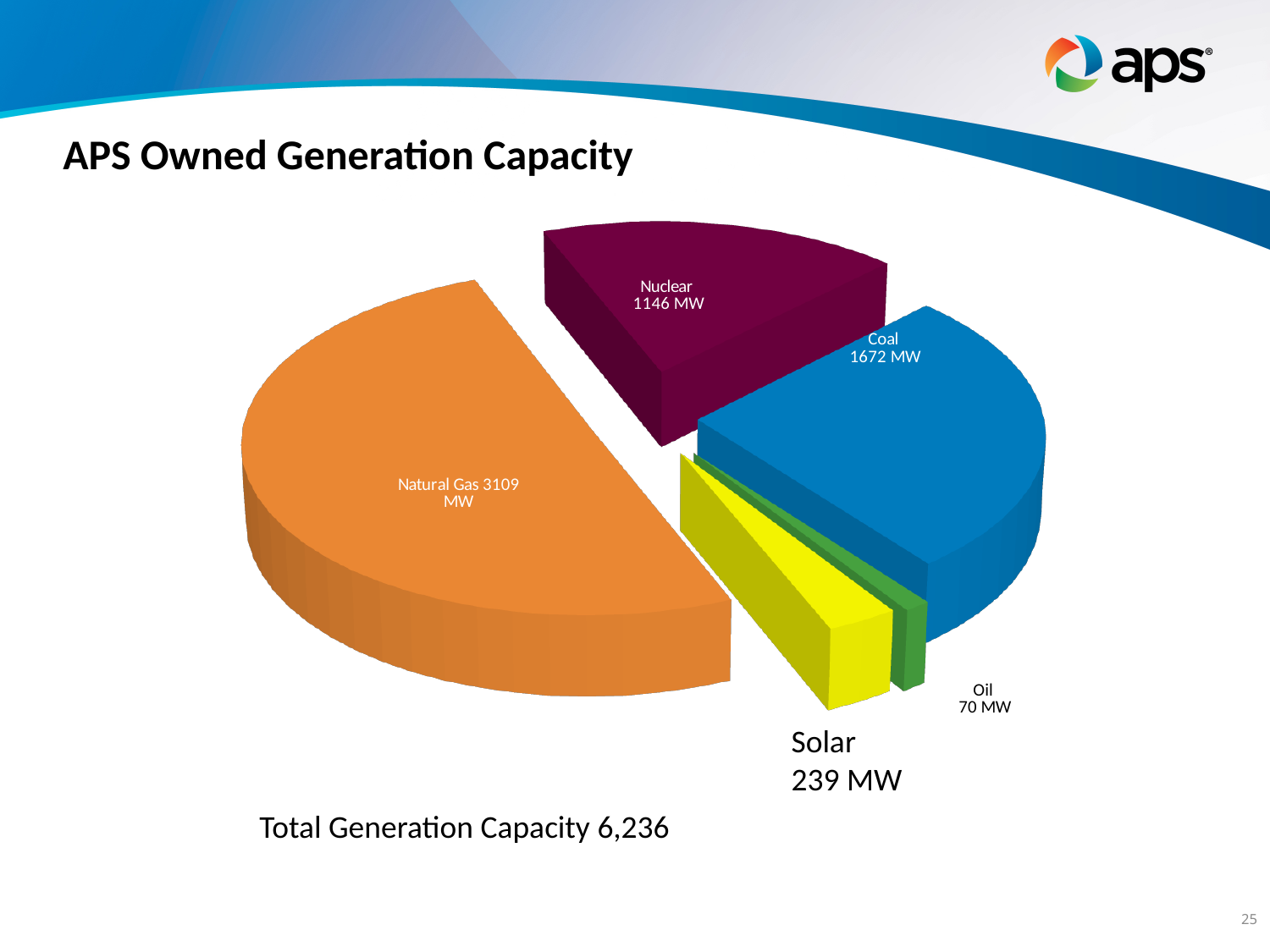
Which has a larger capacity, Nuclear or Coal? Coal What is the generation capacity of Coal? 1672 MW How many generation sources are shown in the pie chart? 5 Which source has the largest generation capacity? Natural Gas What is the generation capacity of Natural Gas in the pie chart? 3109 MW How much larger is Coal's capacity than Nuclear's capacity? 526 MW What is the difference between Solar and Oil capacity? 169 MW What type of chart is shown on the slide? Pie chart Which source has the smallest generation capacity? Oil What is the generation capacity of Oil? 70 MW What is the total generation capacity stated on the slide? 6,236 What is the generation capacity of Solar? 239 MW